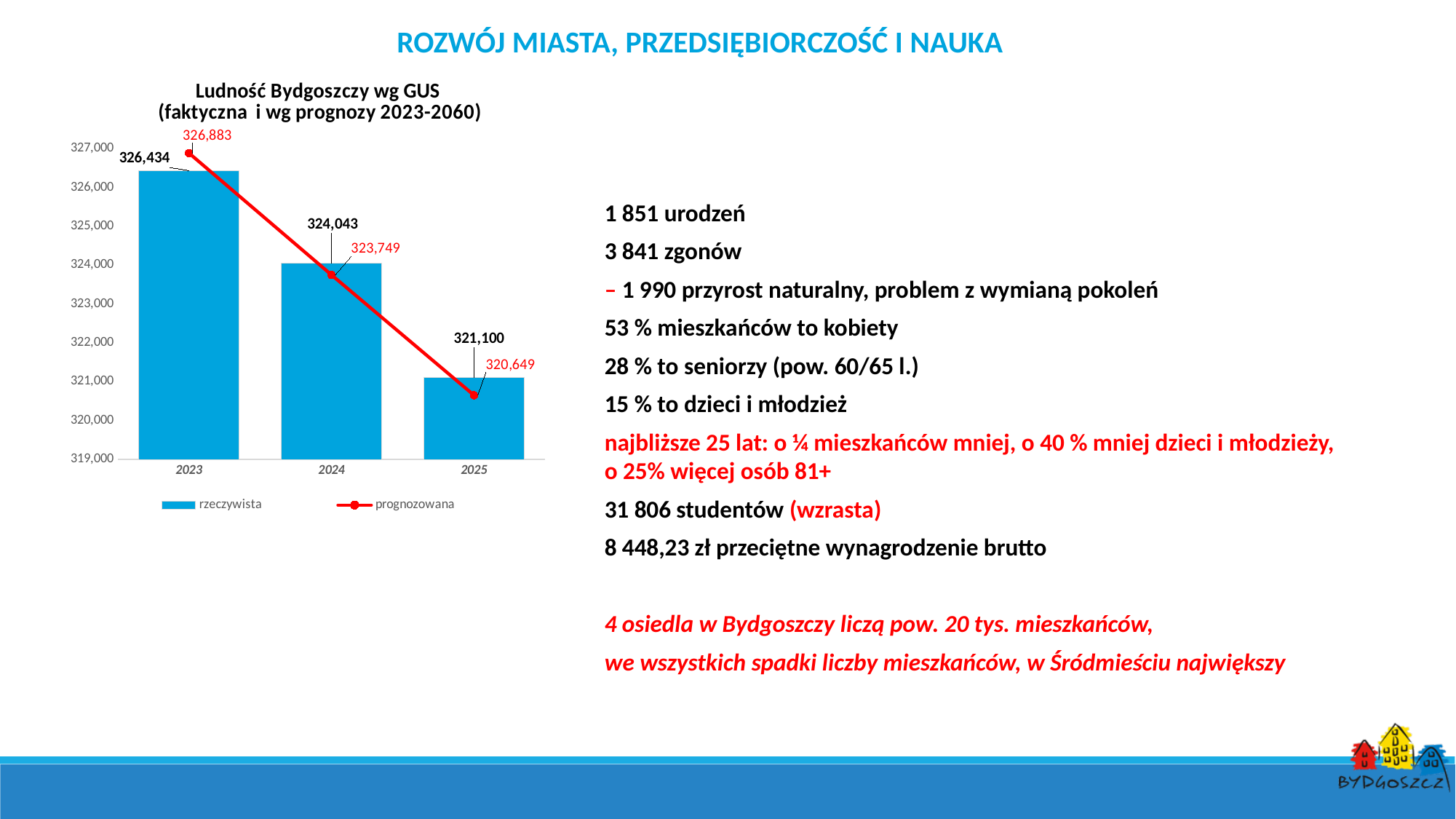
Which year has the lowest prognozowana value? 2025 Is the rzeczywista value for 2024 greater or less than 323,000? greater For 2023, which is larger: the rzeczywista value or the prognozowana value? prognozowana What is the value of the rzeczywista (actual) population for 2023? 326,434 What is the rzeczywista value for 2024? 324,043 How many series does the chart legend list? 2 How many years are shown on the x axis of the chart? 3 Which year has the highest rzeczywista population value? 2023 What is the prognozowana (forecast) population value for 2025? 320,649 What is the difference between the rzeczywista values for 2023 and 2024? 2,391 Do the rzeczywista values rise or fall from 2023 to 2025? fall What is the difference between the rzeczywista and prognozowana values for 2025? 451